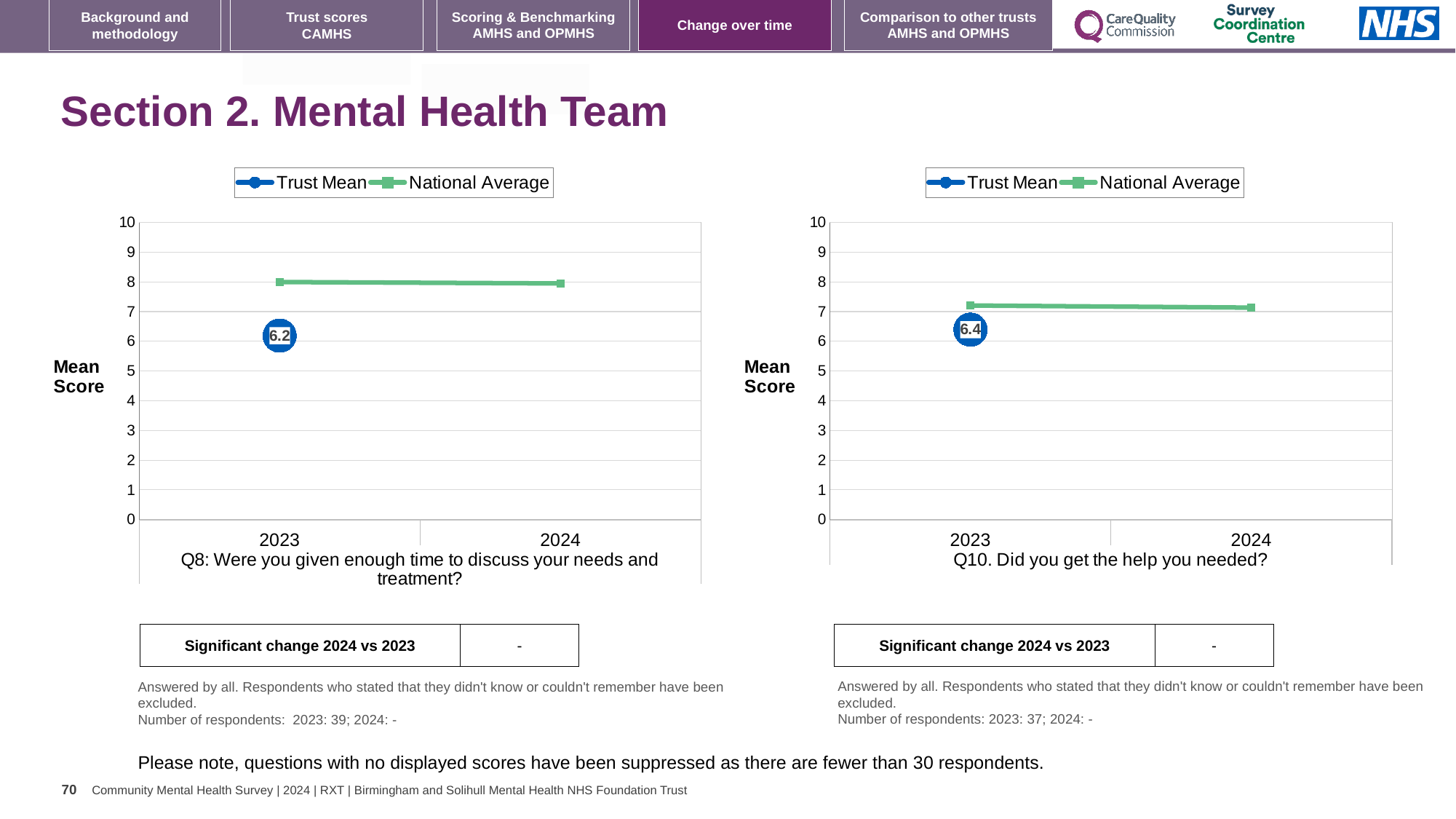
What is the y-axis title of the right chart (Q10)? Mean Score In the right chart (Q10. Did you get the help you needed?), what is the Trust Mean score for 2023? 6.4 In the right chart (Q10), is the Trust Mean value for 2023 greater or less than 7? less In the left chart (Q8), which is higher in 2023: the Trust Mean or the National Average? National Average How many series does the legend of the right chart (Q10) list? 2 In the right chart (Q10), which is lower in 2023: the Trust Mean or the National Average? Trust Mean How many years are shown on the x axis of the left chart (Q8)? 2 In the right chart (Q10), is the National Average value for 2024 greater or less than 8? less In the left chart (Q8), is the National Average value for 2023 greater or less than 7? greater What are the two series named in the legend of the left chart (Q8)? Trust Mean and National Average What kind of chart is the left chart (Q8)? Line chart In the left chart (Q8: Were you given enough time to discuss your needs and treatment?), what is the Trust Mean score for 2023? 6.2